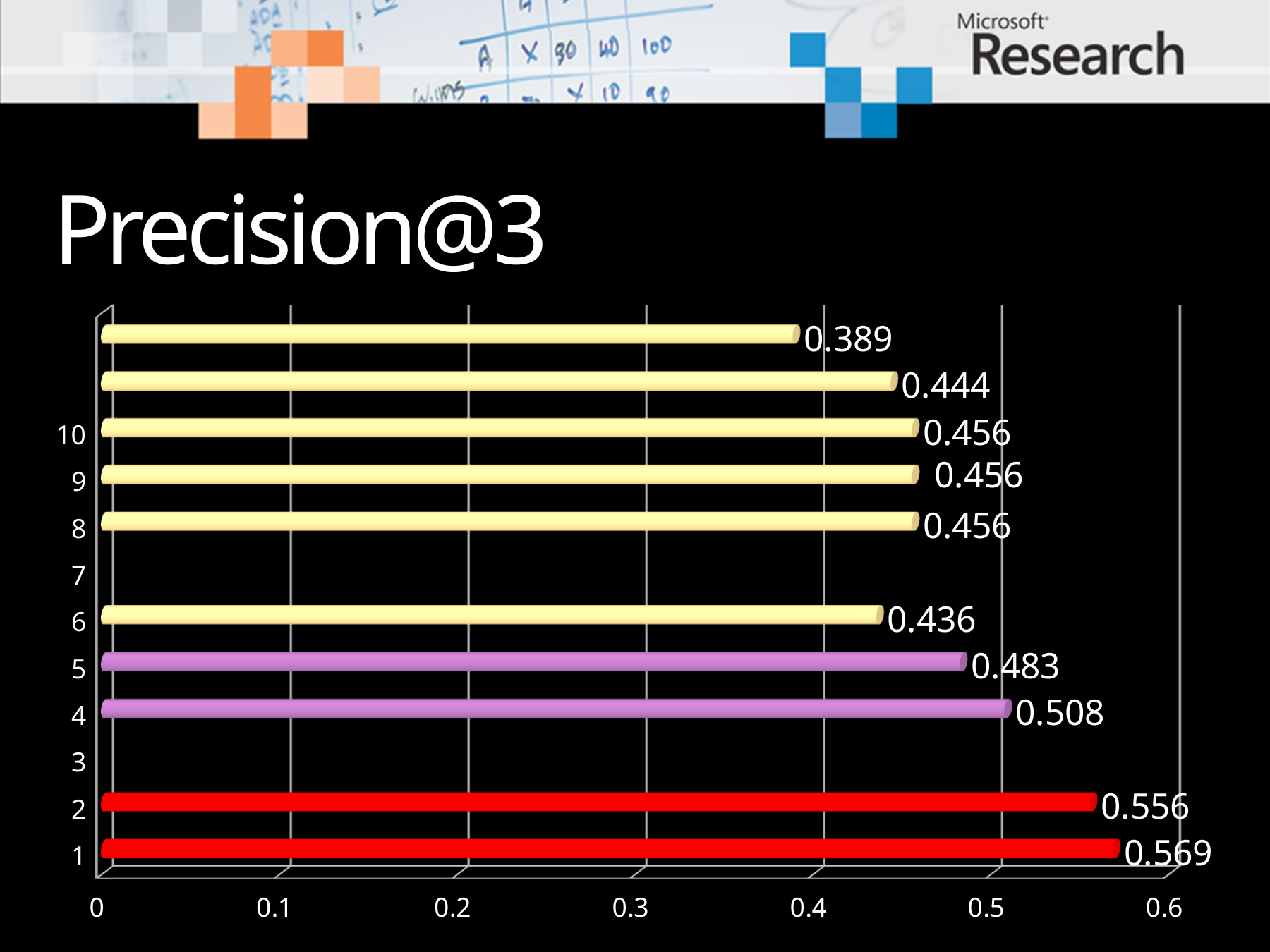
What colour are the bars for categories 1 and 2? red What kind of chart is shown on the slide? bar chart What is the Precision@3 value for category 9? 0.456 Is the Precision@3 value for category 4 greater or less than 0.5? greater What is the difference between the Precision@3 values for category 1 and category 2? 0.013 Which category has the highest Precision@3 value? 1 What is the difference between the Precision@3 values for category 4 and category 5? 0.025 Which has a larger Precision@3 value, category 5 or category 6? category 5 What is the Precision@3 value for category 4? 0.508 Which has a larger Precision@3 value, category 2 or category 8? category 2 What is the Precision@3 value for category 1? 0.569 What is the Precision@3 value for category 6? 0.436